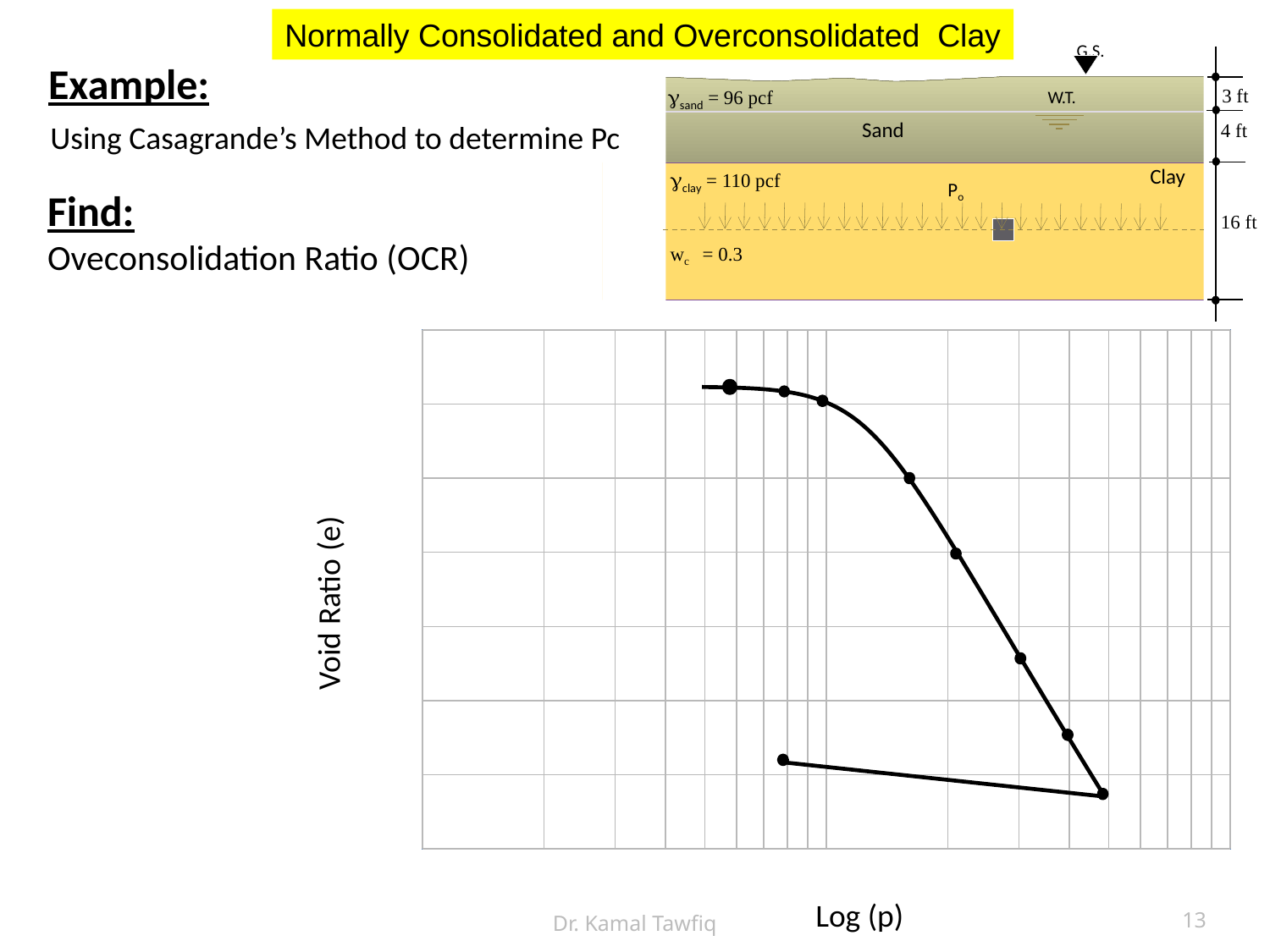
How many data points are plotted on the chart? 9 What kind of chart is shown on the slide? line chart Which has the higher void ratio: the leftmost point of the main curve or the rightmost point of the curve? the leftmost point Along the main curve, does the void ratio rise or fall as Log (p) increases? fall What is the label of the horizontal axis of the chart? Log (p) What is the label of the vertical axis of the chart? Void Ratio (e)